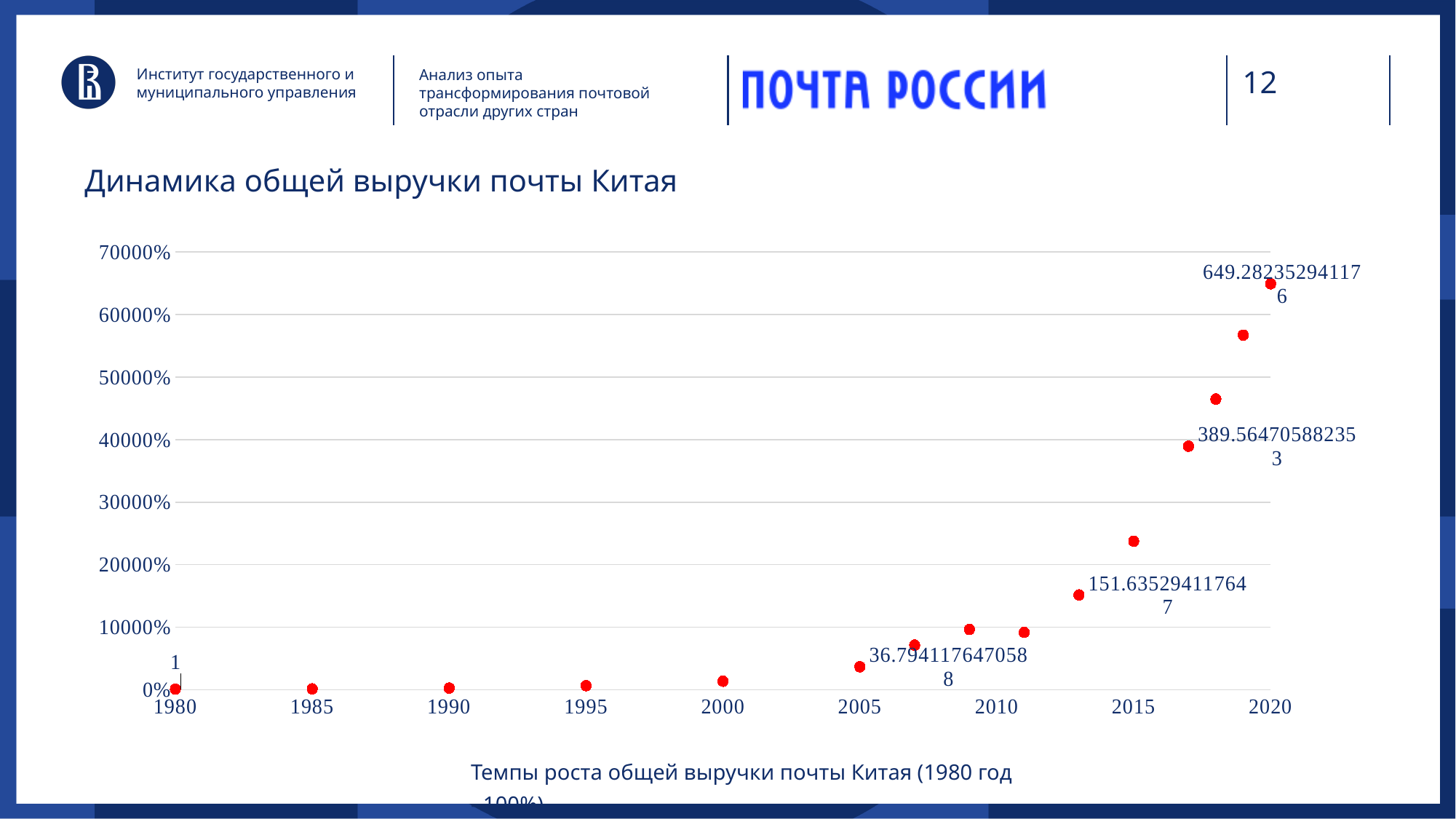
What data label is shown for the point at 2017? 389.564705882353 Do the values generally rise or fall from 1980 to 2020? rise Which year has the lowest value on the chart? 1980 What data label is shown for the point at 2013? 151.635294117647 What type of chart is shown on the slide? scatter chart Is the value for 2019 greater or less than 50000%? greater What data label is shown for the point at 1980? 1 What data label is shown for the point at 2020? 649.282352941176 Which year has the highest value on the chart? 2020 What is the title of the chart on the slide? Динамика общей выручки почты Китая